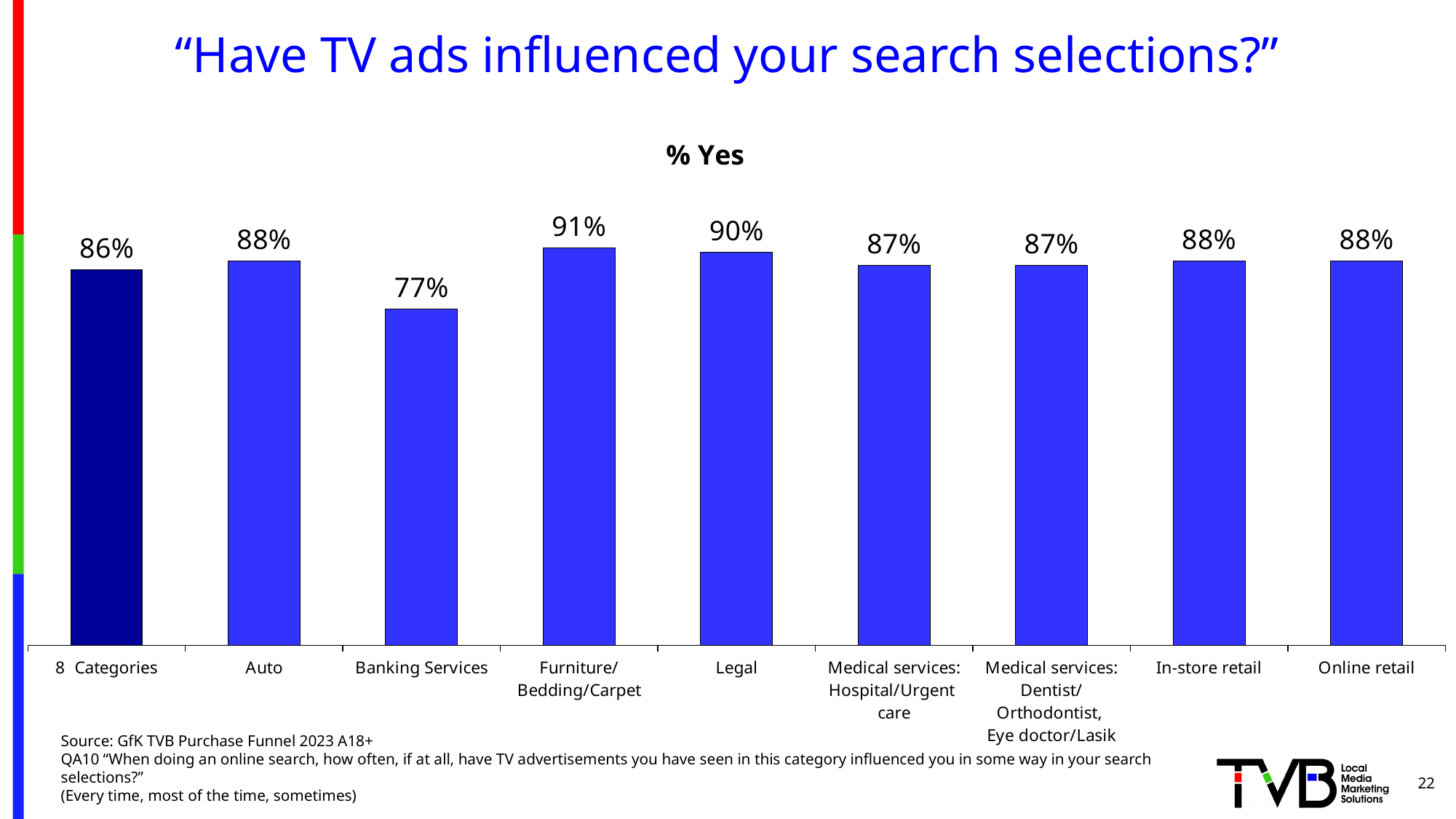
Which has a higher % Yes value, Auto or Banking Services? Auto What is the difference between the % Yes values for Legal and the 8 Categories bar? 4% What kind of chart is shown on the slide? Bar chart What is the % Yes value for Furniture/Bedding/Carpet? 91% Which category has the highest % Yes value? Furniture/Bedding/Carpet What is the % Yes value for the 8 Categories bar? 86% What is the title shown above the chart? % Yes Which category has the lowest % Yes value? Banking Services What is the difference between the % Yes values for Furniture/Bedding/Carpet and Banking Services? 14% What is the % Yes value for Banking Services? 77% How many bars are shown in the chart? 9 What is the % Yes value for Legal? 90%